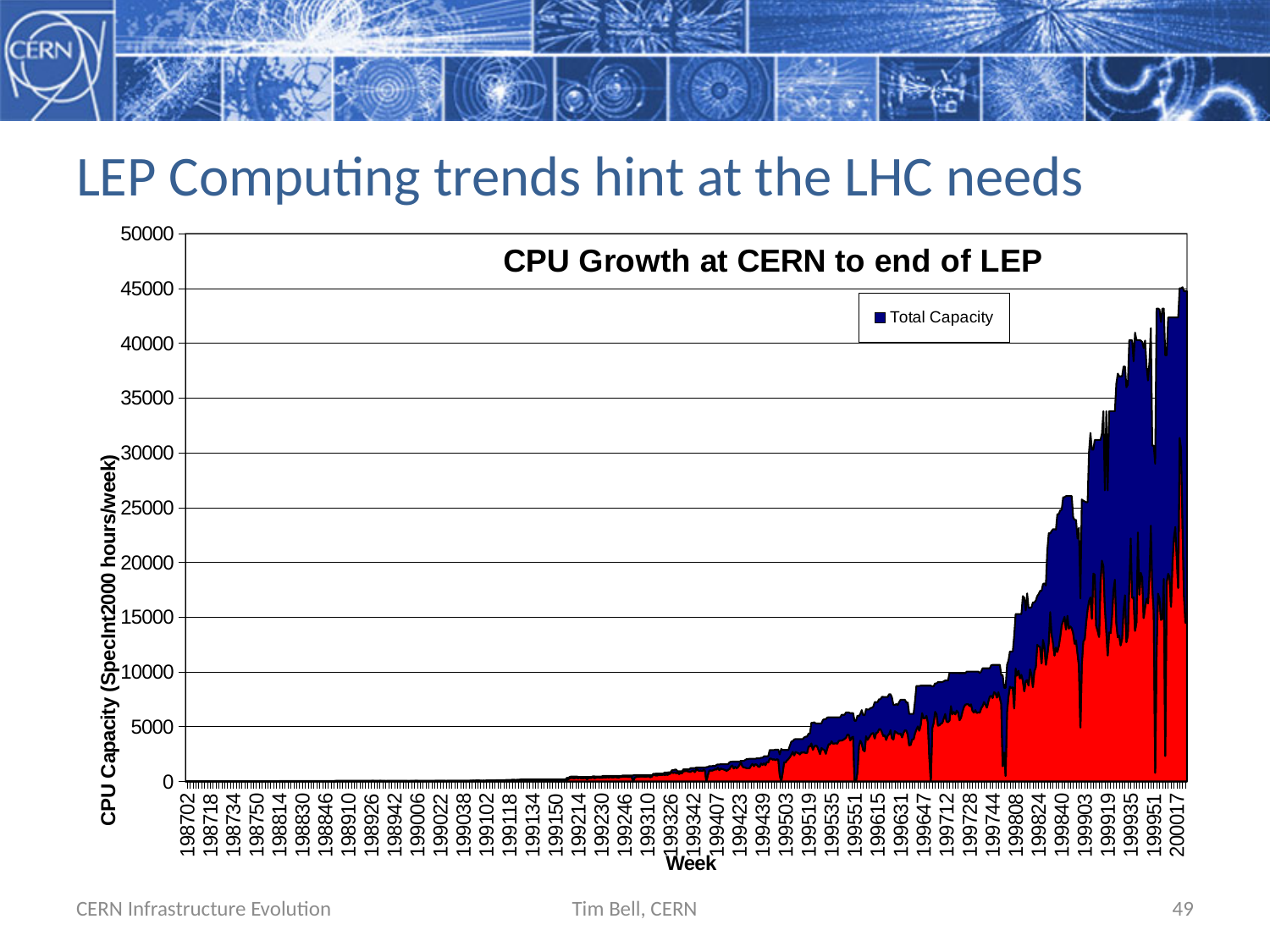
Overall, do the Total Capacity values rise or fall from week 198702 to week 200017? rise Is the Total Capacity value at week 198702 greater or less than 5000? less What is the title of the chart on the slide? CPU Growth at CERN to end of LEP What is the highest value shown on the chart's vertical axis? 50000 What kind of chart is shown on the slide? area chart What is the name of the series listed in the chart's legend? Total Capacity Which is larger, the Total Capacity at week 199519 or at week 199919? 199919 Is the Total Capacity value at week 199503 greater or less than 5000? less How many series does the chart's legend list? 1 Is the Total Capacity value at week 199631 greater or less than 10000? less